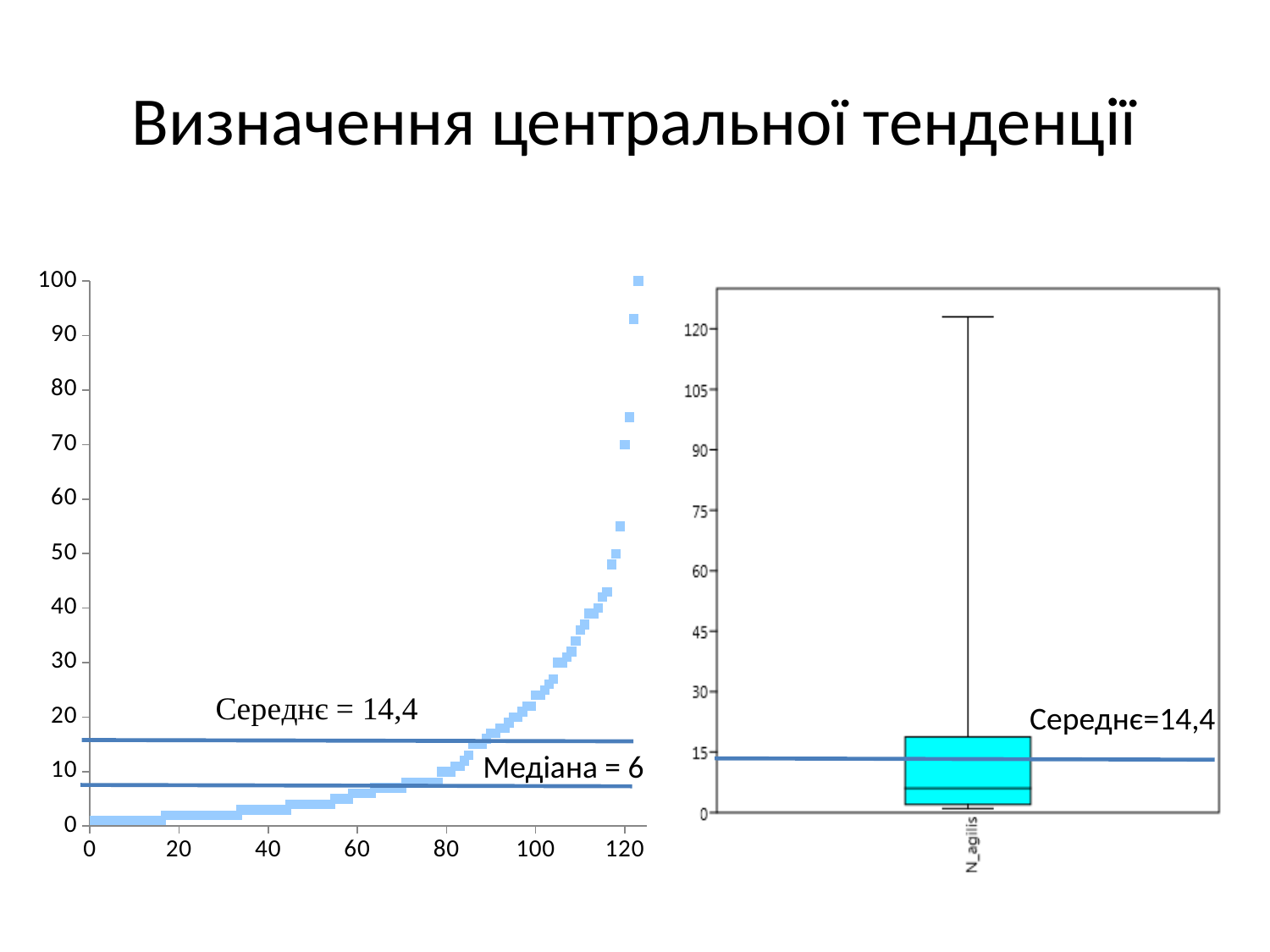
On the right chart, what value of Середнє is labelled? 14,4 On the left chart, what is the value of Середнє (the mean) shown on the slide? 14,4 On the right chart, is the top of the upper whisker greater or less than 105? greater What is the highest tick value on the y axis of the left chart? 100 On the left chart, do the plotted values rise or fall as you move along the x axis from 0 to 120? rise What kind of chart is the chart on the left of the slide? scatter chart On the left chart, what is the value of Медіана (the median) shown on the slide? 6 What kind of chart is the chart on the right of the slide? box plot On the left chart, what is the difference between Середнє (14,4) and Медіана (6)? 8,4 On the left chart, which is larger, Середнє or Медіана? Середнє What is the category label on the x axis of the right chart? N_agilis On the left chart, is the highest plotted point greater or less than 90? greater